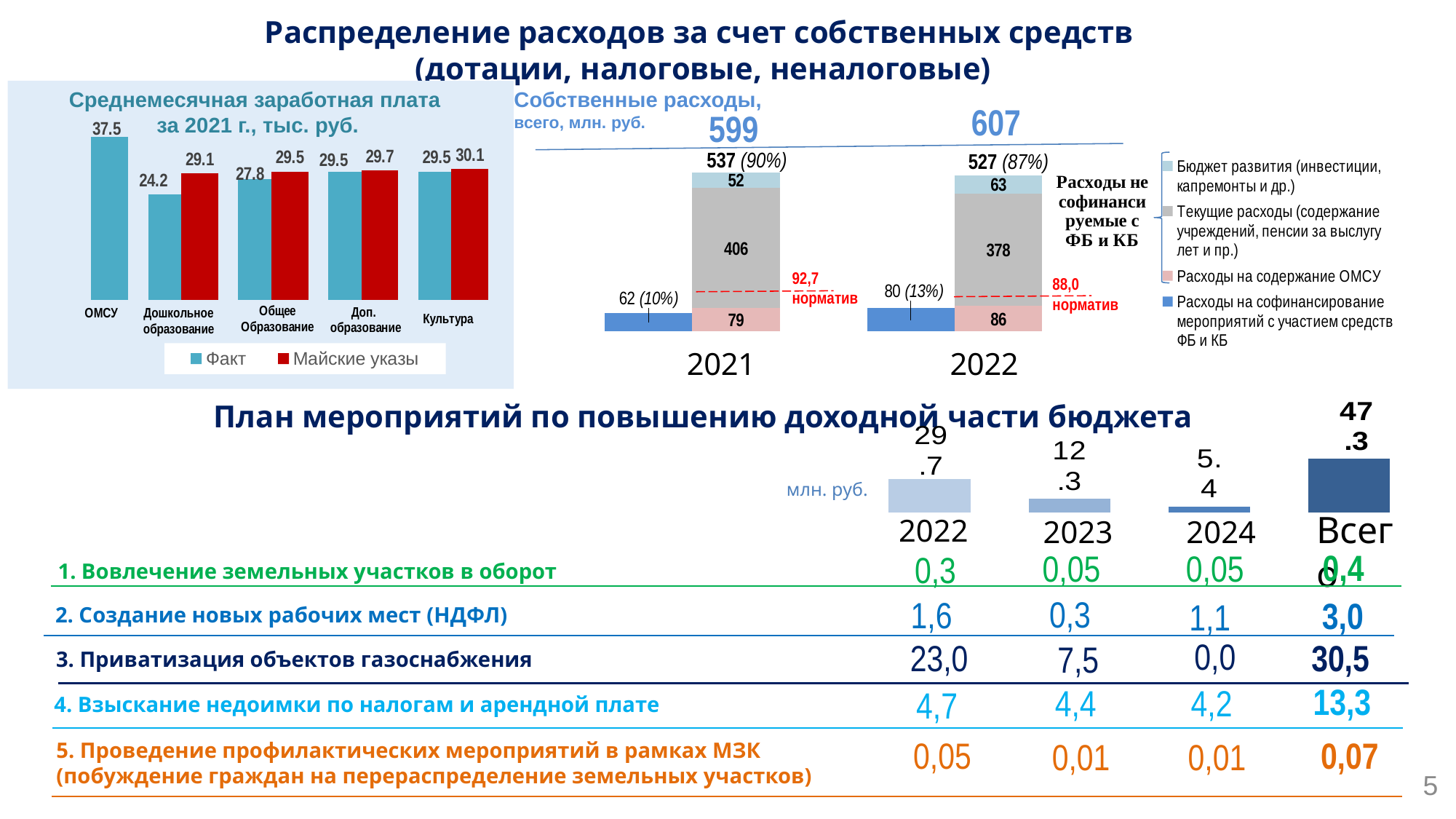
In the chart 'Среднемесячная заработная плата за 2021 г., тыс. руб.', which category has the lowest Факт value? Дошкольное образование In the chart 'Среднемесячная заработная плата за 2021 г., тыс. руб.', how many series does the legend list? 2 In the chart 'Собственные расходы, всего, млн. руб.', what is the value of Текущие расходы for 2021? 406 In the chart 'Собственные расходы, всего, млн. руб.', what is the total for 2022? 607 In the chart 'Собственные расходы, всего, млн. руб.', what is the difference between the Бюджет развития values for 2022 and 2021? 11 In the chart 'Среднемесячная заработная плата за 2021 г., тыс. руб.', what is the difference between the Майские указы and Факт values for Дошкольное образование? 4.9 In the chart 'Среднемесячная заработная плата за 2021 г., тыс. руб.', which category has the highest Факт value? ОМСУ In the chart 'Собственные расходы, всего, млн. руб.', what is the value of Расходы на содержание ОМСУ for 2022? 86 In the chart 'Среднемесячная заработная плата за 2021 г., тыс. руб.', what is the Факт value for ОМСУ? 37.5 In the chart 'Собственные расходы, всего, млн. руб.', how many entries does the legend list? 4 In the small bar chart under 'План мероприятий по повышению доходной части бюджета', what is the value for 2023? 12.3 In the chart 'Среднемесячная заработная плата за 2021 г., тыс. руб.', what is the Майские указы value for Дошкольное образование? 29.1